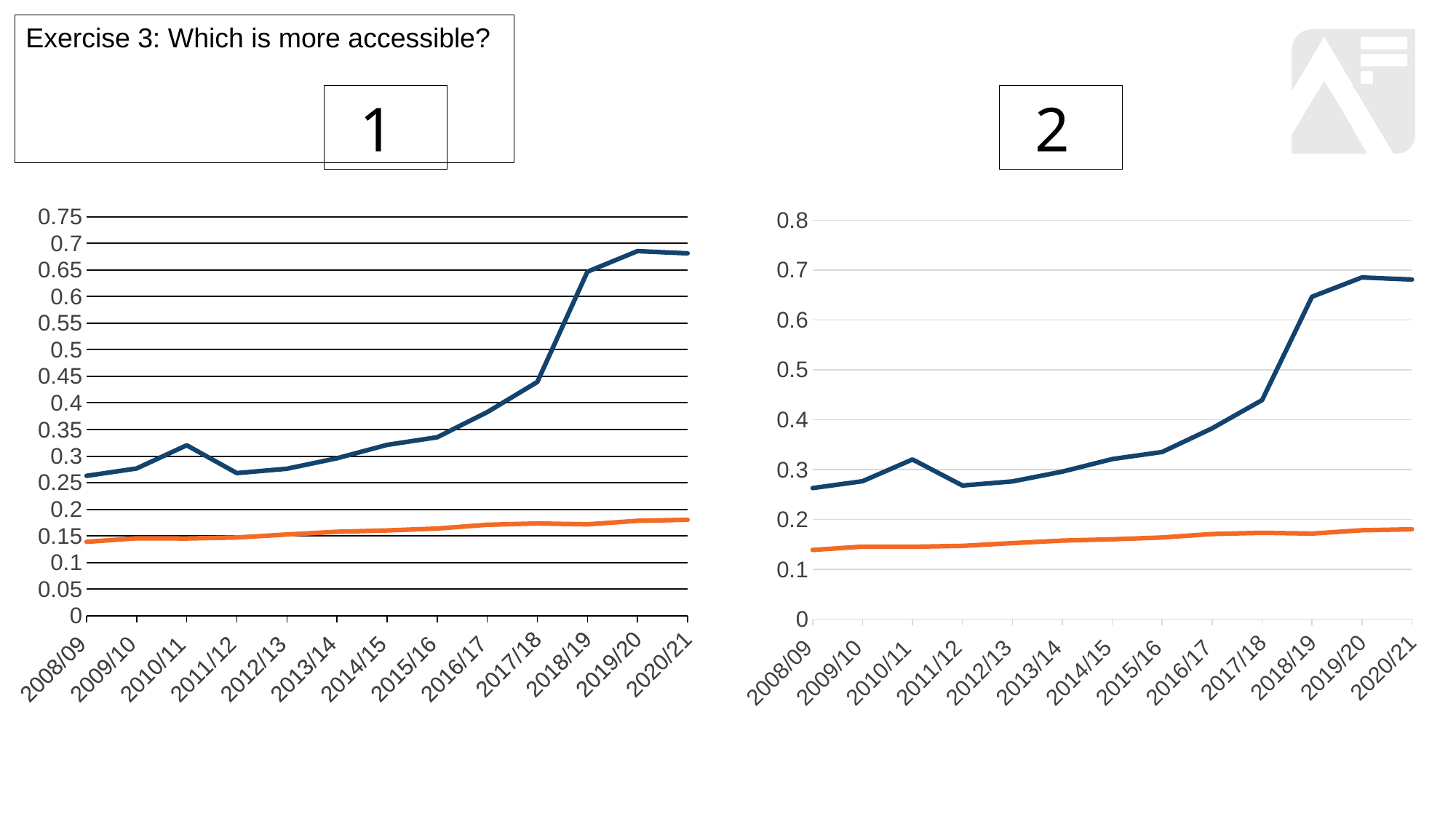
In chart 1 (on the left), does the orange line generally rise or fall from 2008/09 to 2020/21? rise In chart 1 (on the left), is the value of the orange line for 2020/21 greater or less than 0.2? less How many lines are plotted in chart 1 (on the left)? 2 In chart 2 (on the right), is the value of the dark blue line for 2008/09 greater or less than 0.3? less In chart 1 (on the left), is the value of the dark blue line for 2018/19 greater or less than 0.6? greater In chart 1 (on the left), how many academic years are shown on the x axis? 13 What kind of chart is chart 1 (on the left)? line chart In chart 2 (on the right), does the dark blue line rise or fall between 2017/18 and 2018/19? rise In chart 2 (on the right), how many academic years are shown on the x axis? 13 In chart 2 (on the right), which line has the larger value in 2020/21, the dark blue line or the orange line? the dark blue line What kind of chart is chart 2 (on the right)? line chart